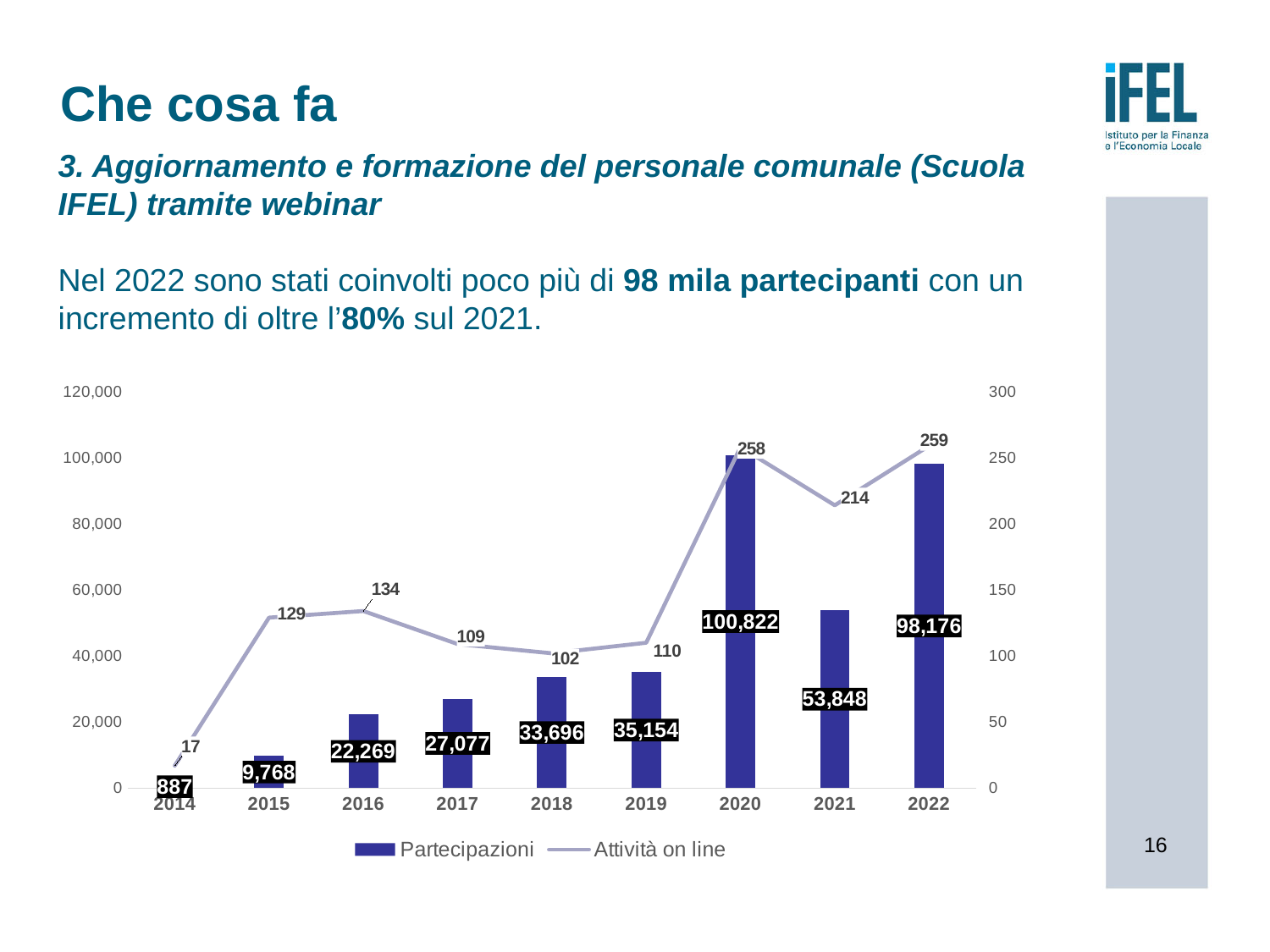
What is the difference in Partecipazioni between 2022 and 2021? 44,328 What is the value of Attività on line for 2016? 134 Which year has more Partecipazioni, 2019 or 2021? 2021 How many series does the legend list? 2 What is the value of Attività on line for 2021? 214 What is the value of Partecipazioni for 2022? 98,176 How many years are shown on the x axis? 9 What kind of chart is shown on the slide? Combined bar and line chart In which year is Partecipazioni highest? 2020 In which year is Attività on line lowest? 2014 What is the value of Partecipazioni for 2018? 33,696 What is the difference in Attività on line between 2022 and 2021? 45